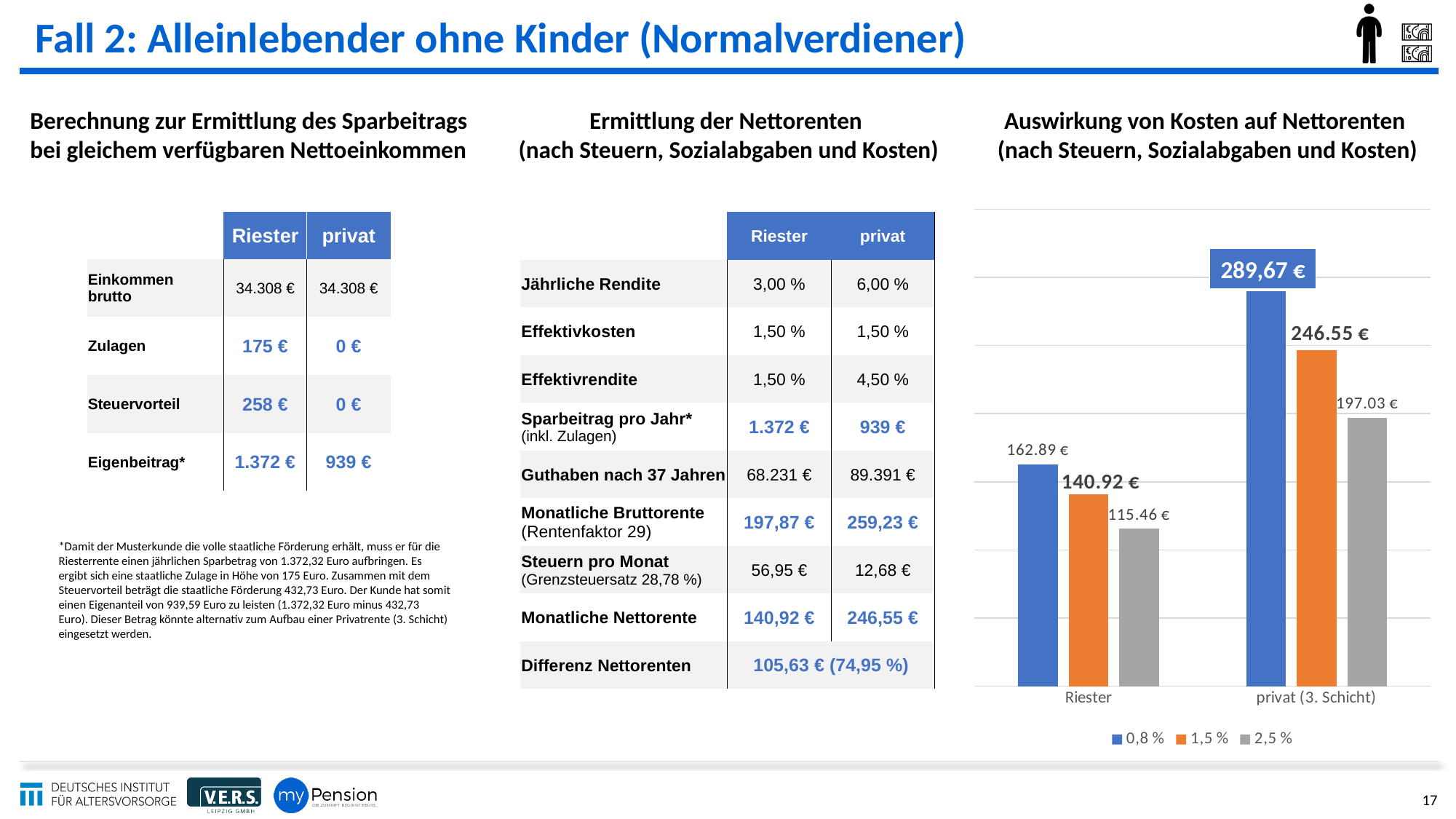
In the chart 'Auswirkung von Kosten auf Nettorenten', which bar has the highest value? privat (3. Schicht), 0,8 % In the chart 'Auswirkung von Kosten auf Nettorenten', what is the difference between the 1,5 % values for privat (3. Schicht) and Riester? 105.63 € In the chart 'Auswirkung von Kosten auf Nettorenten', what is the difference between the 2,5 % values for privat (3. Schicht) and Riester? 81.57 € How many categories are shown on the x axis of the chart 'Auswirkung von Kosten auf Nettorenten'? 2 In the chart 'Auswirkung von Kosten auf Nettorenten', which is larger: the 2,5 % value for privat (3. Schicht) or the 0,8 % value for Riester? privat (3. Schicht) 2,5 % In the chart 'Auswirkung von Kosten auf Nettorenten', which bar has the lowest value? Riester, 2,5 % In the chart 'Auswirkung von Kosten auf Nettorenten', what is the value for privat (3. Schicht) in the 1,5 % series? 246.55 € In the chart 'Auswirkung von Kosten auf Nettorenten', what is the value for Riester in the 0,8 % series? 162.89 € What kind of chart is shown under the title 'Auswirkung von Kosten auf Nettorenten'? bar chart In the chart 'Auswirkung von Kosten auf Nettorenten', what is the value for privat (3. Schicht) in the 0,8 % series? 289,67 € How many series does the legend of the chart 'Auswirkung von Kosten auf Nettorenten' list? 3 In the chart 'Auswirkung von Kosten auf Nettorenten', what is the value for Riester in the 2,5 % series? 115.46 €